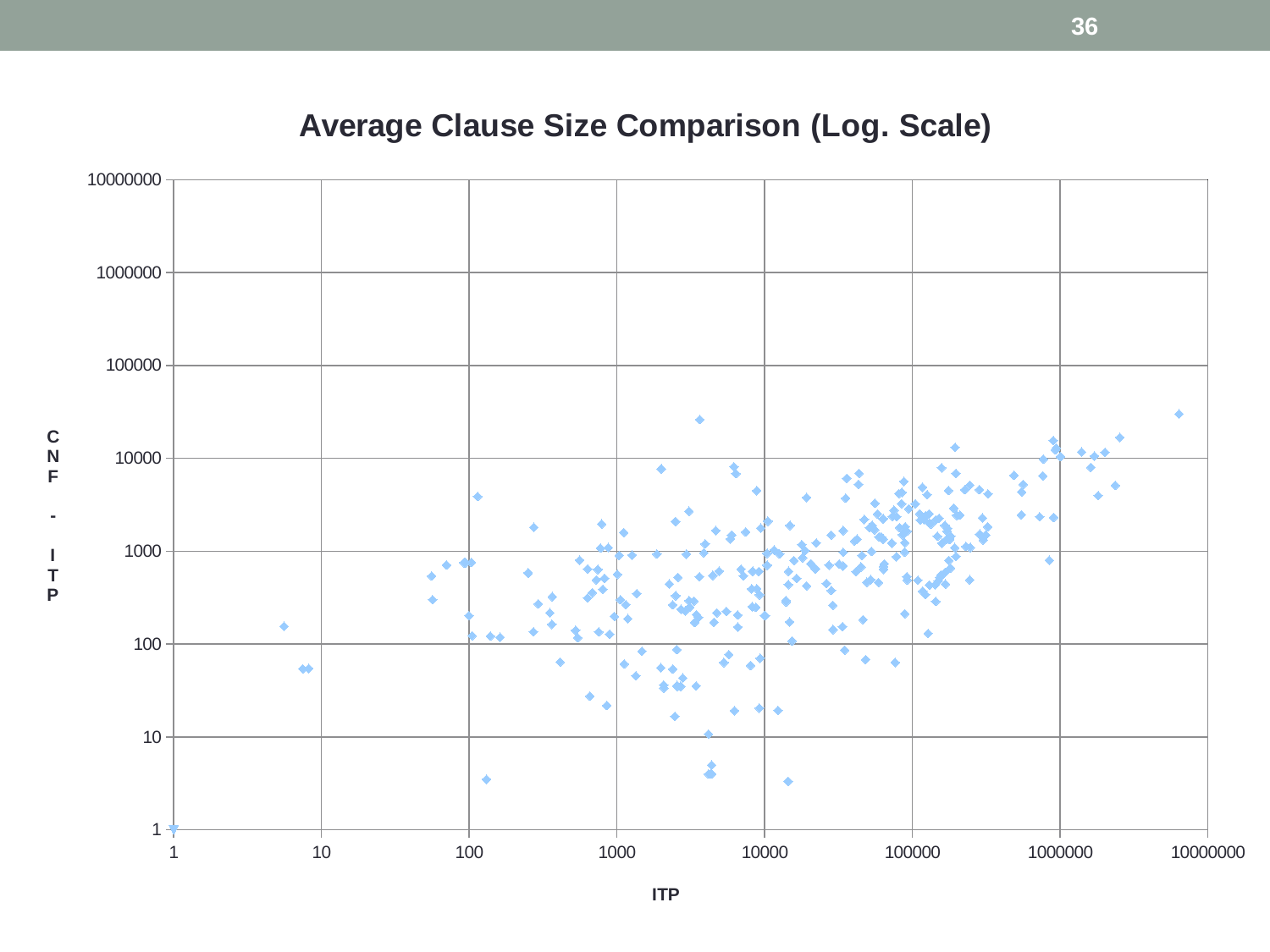
Do the plotted CNF-ITP values generally rise or fall as ITP increases along the x axis? Rise Is the highest plotted CNF-ITP value greater or less than 100000? less What is the label of the x axis? ITP How many tick labels are shown on the y axis? 8 How many tick labels are shown on the x axis? 8 Is the lowest plotted CNF-ITP value greater or less than 10? less Is the highest plotted CNF-ITP value greater or less than 10000? greater What kind of chart is shown on the slide? Scatter plot What is the title of the chart? Average Clause Size Comparison (Log. Scale)